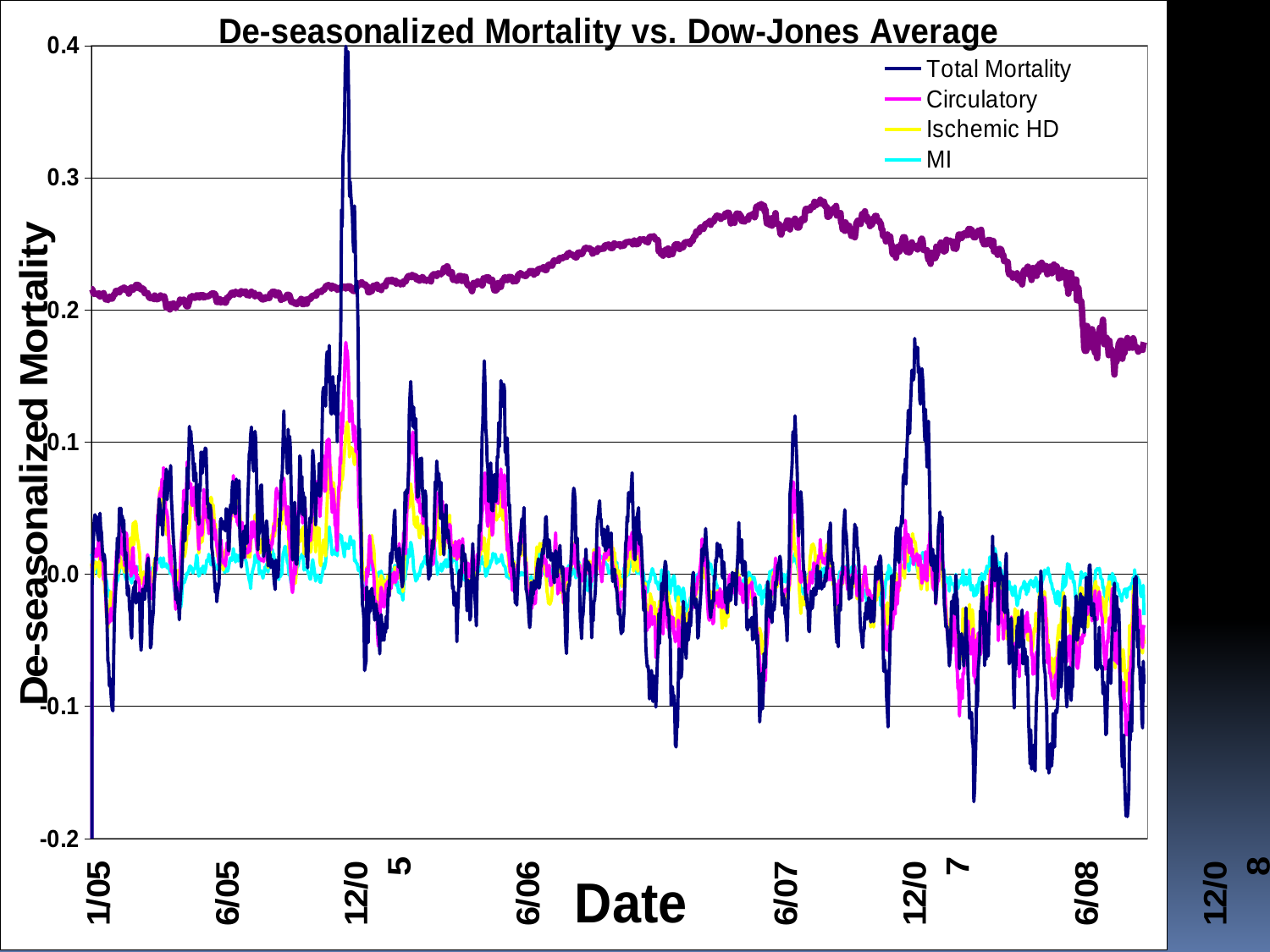
What type of chart is shown on the slide? line chart Is the lowest value of Total Mortality between 12/07 and 6/08 greater or less than -0.1? less Is the peak value of Total Mortality near 12/05 greater or less than 0.3? greater What is the title of the chart? De-seasonalized Mortality vs. Dow-Jones Average Does the thick purple line rise or fall between 6/08 and the right end of the chart? fall Is the highest value reached by the MI series greater or less than 0.1? less Which series reaches the highest peak on the chart? Total Mortality How many series does the legend list? 4 At the spike near 12/05, which is larger: Total Mortality or MI? Total Mortality Which series in the legend is drawn in cyan? MI